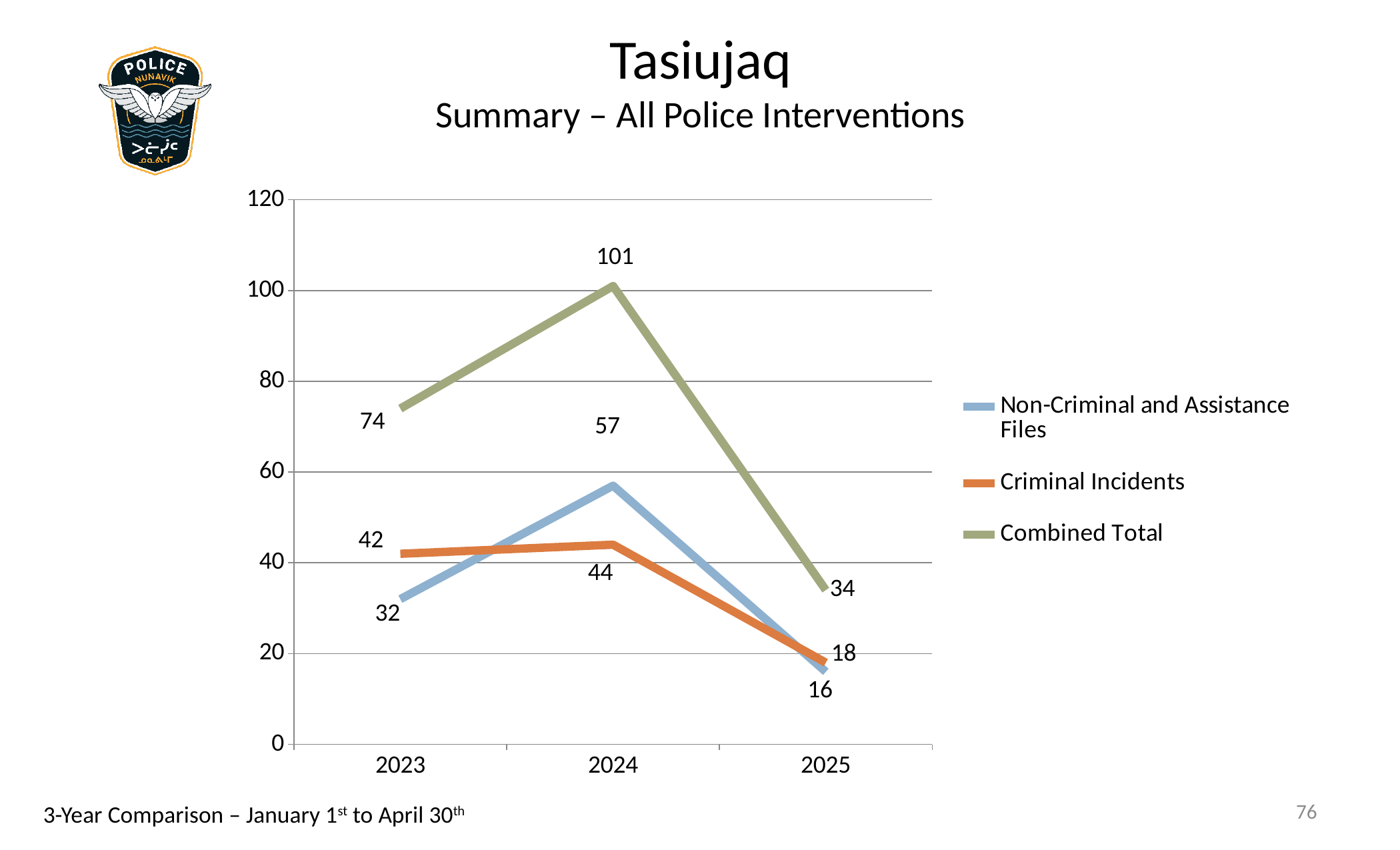
What kind of chart is shown on the slide? Line chart What is the value for Non-Criminal and Assistance Files in 2023? 32 What is the value for Criminal Incidents in 2025? 18 What is the difference between the Combined Total in 2024 and in 2025? 67 In which year is the Combined Total highest? 2024 How many years are shown on the x axis? 3 How many series does the legend list? 3 In which year is the value for Non-Criminal and Assistance Files lowest? 2025 Is the Combined Total for 2023 greater or less than 60? greater What is the Combined Total value for 2024? 101 Which is larger in 2023: Criminal Incidents or Non-Criminal and Assistance Files? Criminal Incidents Does the Criminal Incidents series rise or fall from 2024 to 2025? Fall